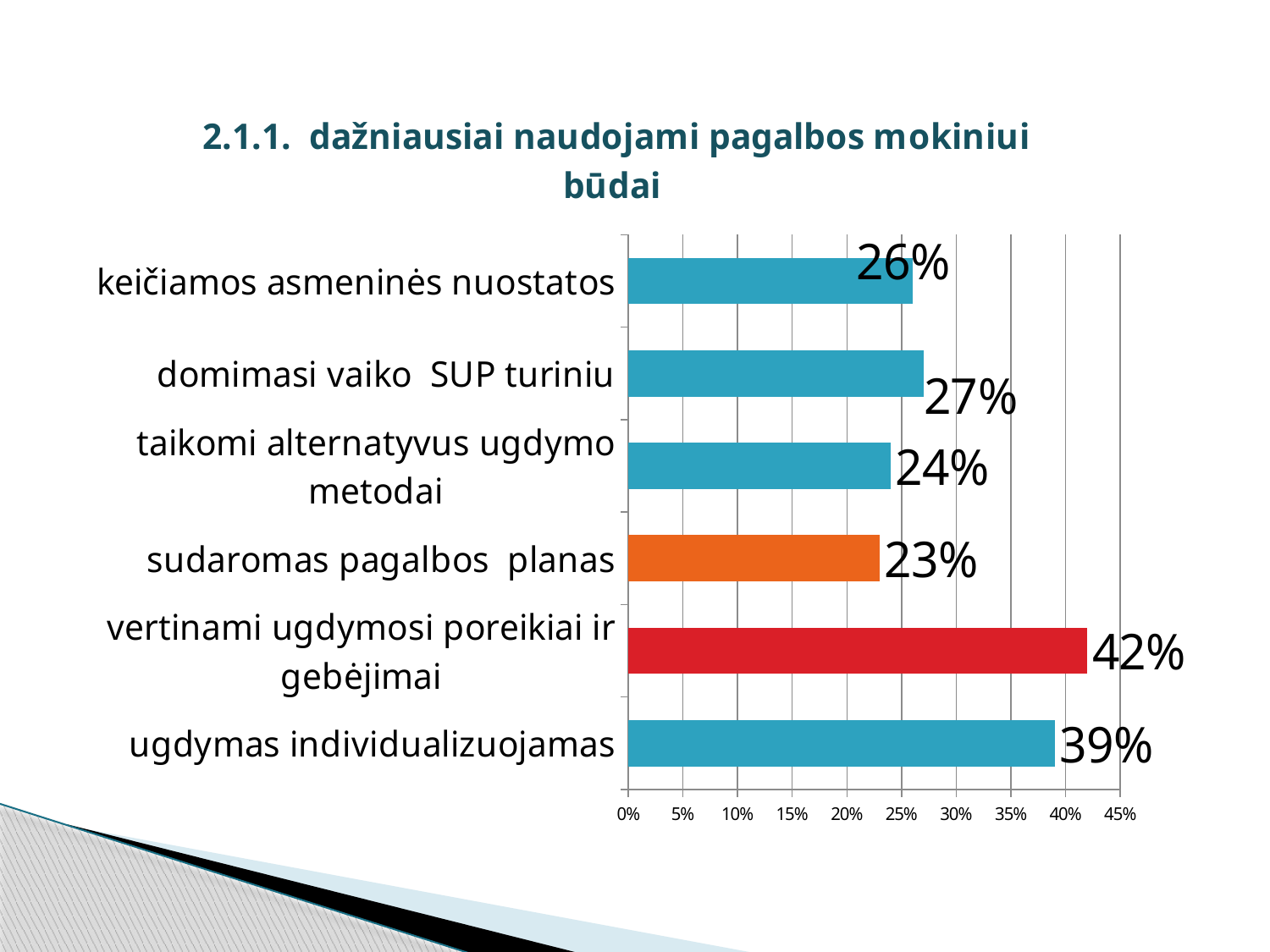
How many categories are shown in the chart? 6 What is the difference between the values for "vertinami ugdymosi poreikiai ir gebėjimai" and "ugdymas individualizuojamas"? 3% What kind of chart is shown on the slide? bar chart Is the value for "ugdymas individualizuojamas" greater or less than 35%? greater What is the title of the chart? 2.1.1. dažniausiai naudojami pagalbos mokiniui būdai What colour is the bar for "sudaromas pagalbos planas"? orange What is the value for "keičiamos asmeninės nuostatos"? 26% What is the value for "sudaromas pagalbos planas"? 23% Which category has the lowest value? sudaromas pagalbos planas Which category has the highest value? vertinami ugdymosi poreikiai ir gebėjimai What is the value for "vertinami ugdymosi poreikiai ir gebėjimai"? 42% Which is larger: the value for "domimasi vaiko SUP turiniu" or the value for "taikomi alternatyvus ugdymo metodai"? domimasi vaiko SUP turiniu